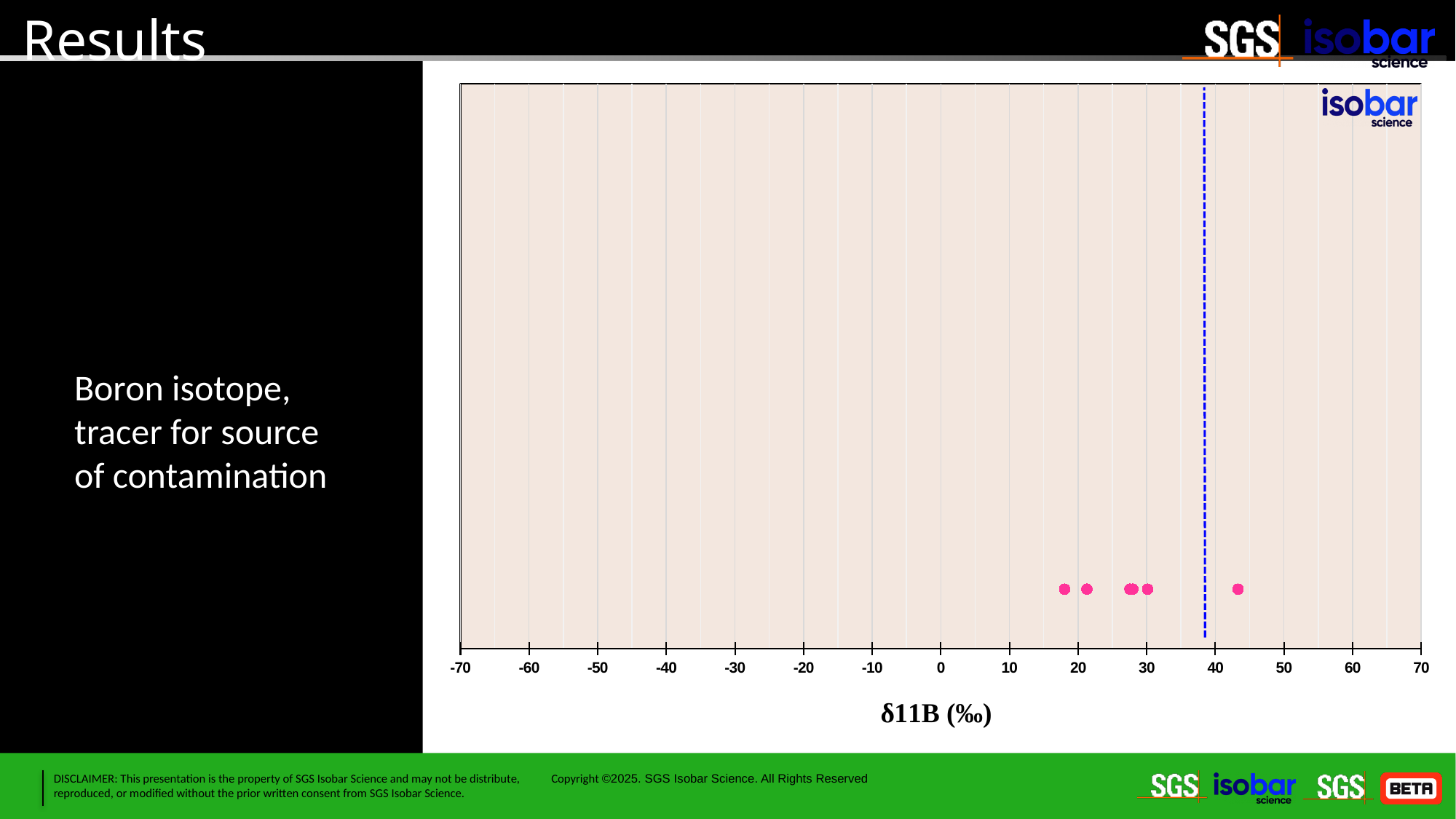
What colour are the plotted data points? Pink Are all the plotted data points greater or less than 0 on the x axis? greater Is the dashed vertical reference line positioned at a value greater or less than 40? less Are all the plotted data points less than 50 on the x axis? Yes What is the label of the x axis of the chart? δ11B (‰) What is the spacing between consecutive tick labels on the x axis? 10 What is the highest value shown on the x axis of the chart? 70 What is the lowest value shown on the x axis of the chart? -70 What kind of chart is shown on the slide? Scatter (dot) plot How many data points lie to the right of the dashed vertical line? 1